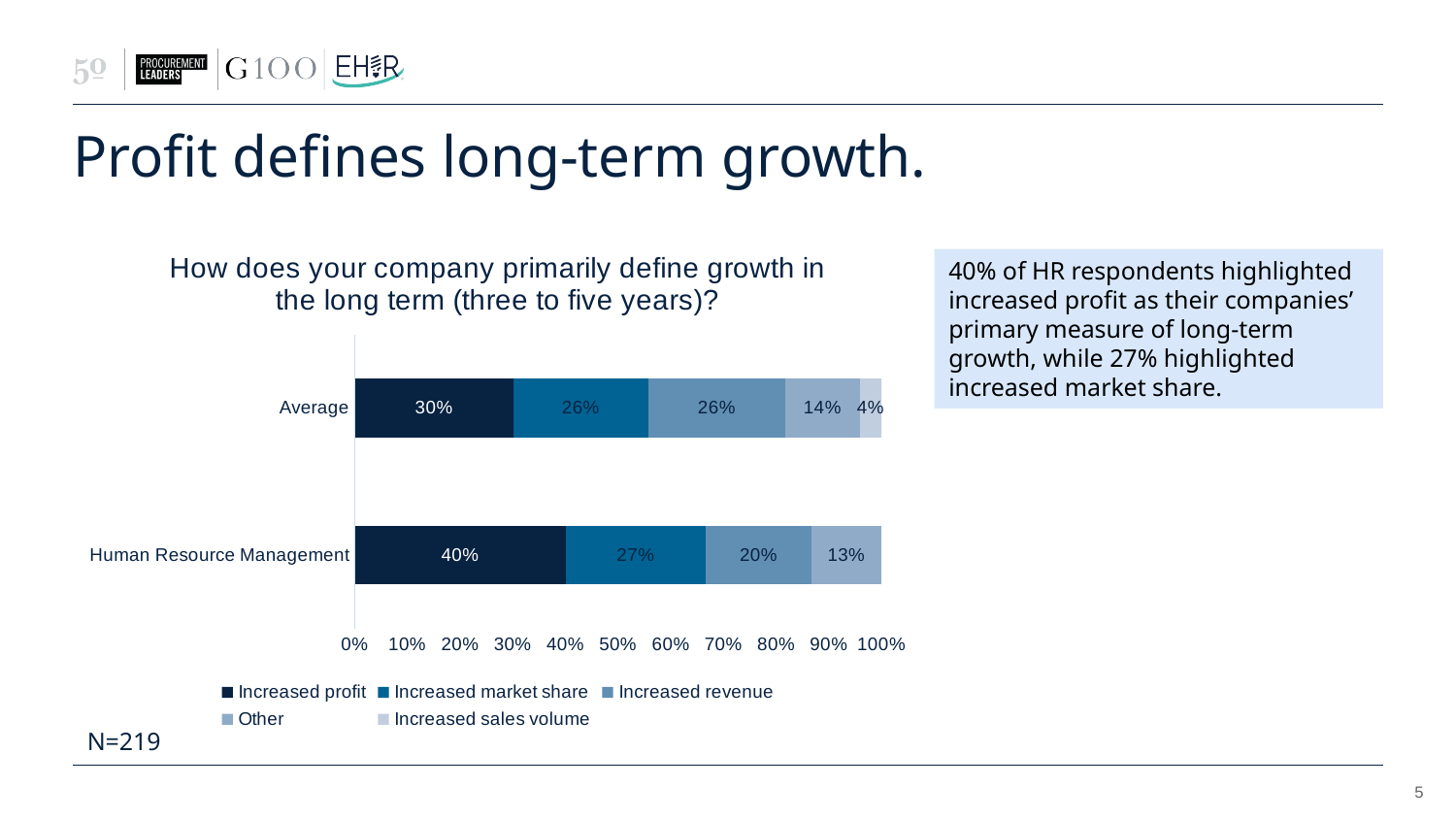
How many categories (bars) are shown on the chart? 2 What is the value for Increased market share in the Human Resource Management bar? 27% What is the value for Increased sales volume in the Average bar? 4% What is the value for Increased profit in the Average bar? 30% What is the value for Increased profit in the Human Resource Management bar? 40% What is the difference between the Increased profit values for Human Resource Management and Average? 10% How many series does the legend list? 5 What is the value for Increased revenue in the Average bar? 26% Which segment is the largest in the Human Resource Management bar? Increased profit Which is larger: Increased revenue for Average or Increased revenue for Human Resource Management? Average What is the value for Other in the Human Resource Management bar? 13% What kind of chart is shown on the slide? Stacked bar chart